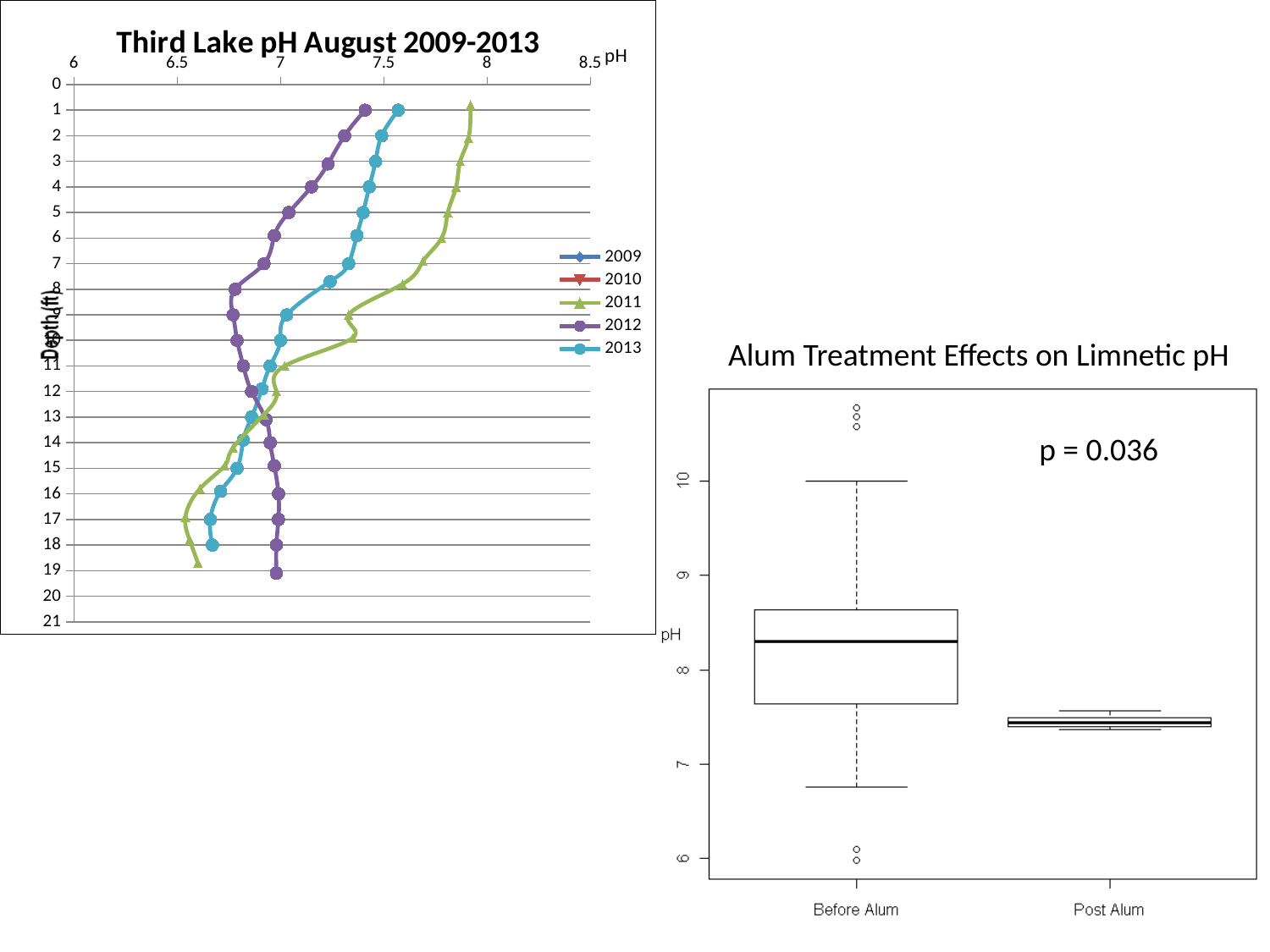
What p-value is printed on the 'Alum Treatment Effects on Limnetic pH' chart? p = 0.036 In the 'Third Lake pH August 2009-2013' chart, is the 2012 pH at a depth of 1 ft greater or less than 7? greater How many series does the legend of the 'Third Lake pH August 2009-2013' chart list? 5 In the 'Third Lake pH August 2009-2013' chart, is the 2012 pH at a depth of 8 ft greater or less than 7? less In the 'Third Lake pH August 2009-2013' chart, does the 2011 pH generally rise or fall as depth increases from 1 ft to 17 ft? fall In the 'Third Lake pH August 2009-2013' chart, is the 2011 pH at a depth of 1 ft greater or less than 7.5? greater In the 'Third Lake pH August 2009-2013' chart, which series has the higher pH at a depth of 1 ft, 2011 or 2012? 2011 What kind of chart is the 'Alum Treatment Effects on Limnetic pH' chart? box plot How many categories are shown on the x axis of the 'Alum Treatment Effects on Limnetic pH' chart? 2 What kind of chart is the 'Third Lake pH August 2009-2013' chart? line chart